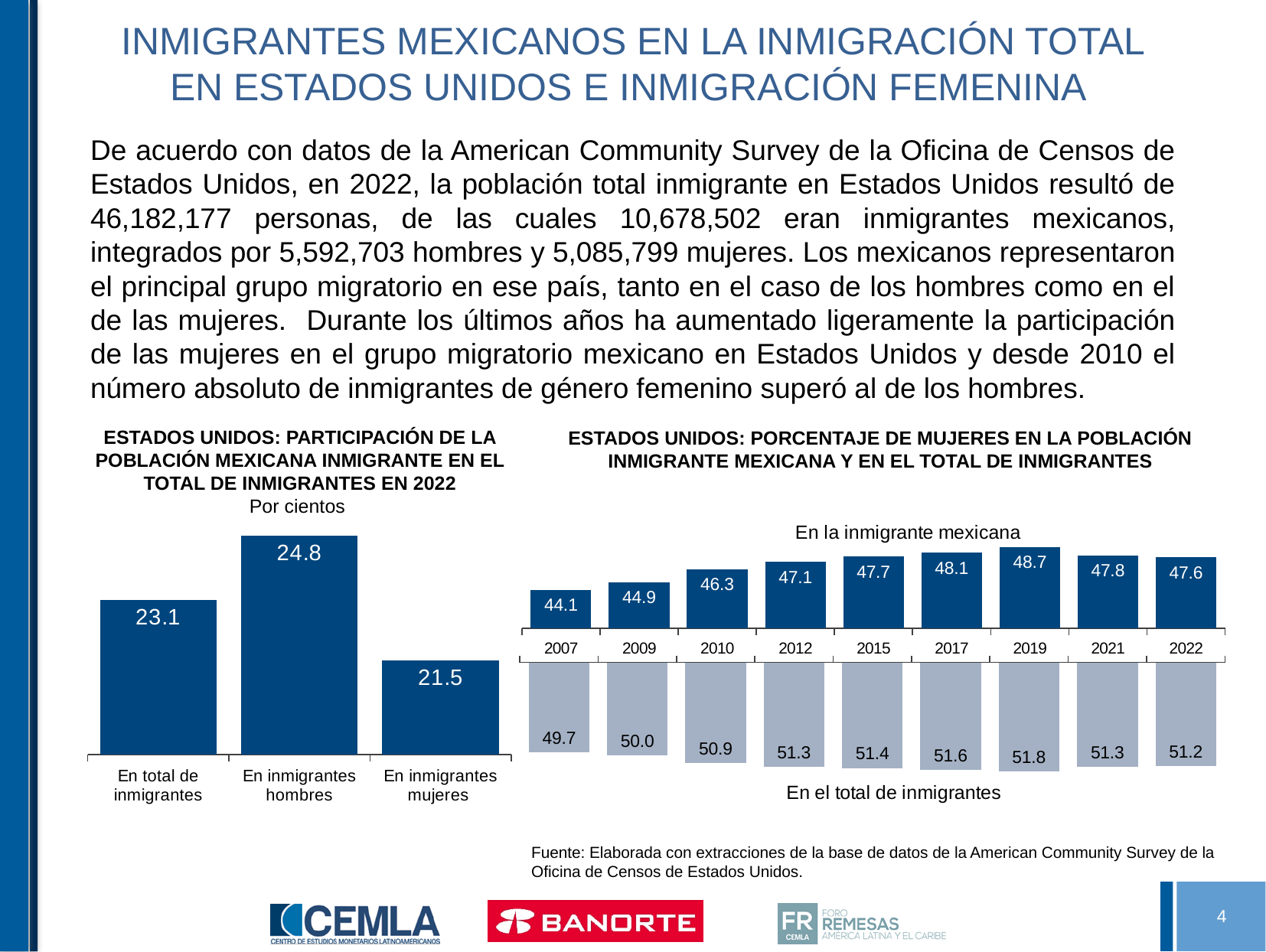
In the right chart (Porcentaje de mujeres en la población inmigrante mexicana y en el total de inmigrantes), in which year is the 'En el total de inmigrantes' value lowest? 2007 In the right chart (Porcentaje de mujeres en la población inmigrante mexicana y en el total de inmigrantes), which is larger in 2010: 'En la inmigrante mexicana' or 'En el total de inmigrantes'? En el total de inmigrantes In the right chart (Porcentaje de mujeres en la población inmigrante mexicana y en el total de inmigrantes), what is the value for 'En el total de inmigrantes' in 2007? 49.7 What kind of chart is the left chart (Participación de la población mexicana inmigrante en el total de inmigrantes en 2022)? Bar chart In the left chart (Participación de la población mexicana inmigrante en el total de inmigrantes en 2022), how many categories are shown? 3 In the right chart (Porcentaje de mujeres en la población inmigrante mexicana y en el total de inmigrantes), in which year is the 'En la inmigrante mexicana' value highest? 2019 In the right chart (Porcentaje de mujeres en la población inmigrante mexicana y en el total de inmigrantes), what is the value for 'En la inmigrante mexicana' in 2019? 48.7 In the left chart (Participación de la población mexicana inmigrante en el total de inmigrantes en 2022), what is the difference between 'En inmigrantes hombres' and 'En inmigrantes mujeres'? 3.3 In the left chart (Participación de la población mexicana inmigrante en el total de inmigrantes en 2022), what is the value for 'En inmigrantes hombres'? 24.8 In the left chart (Participación de la población mexicana inmigrante en el total de inmigrantes en 2022), which category has the lowest value? En inmigrantes mujeres In the right chart (Porcentaje de mujeres en la población inmigrante mexicana y en el total de inmigrantes), how many years are shown on the x axis? 9 In the right chart (Porcentaje de mujeres en la población inmigrante mexicana y en el total de inmigrantes), what is the difference between 'En el total de inmigrantes' and 'En la inmigrante mexicana' in 2022? 3.6